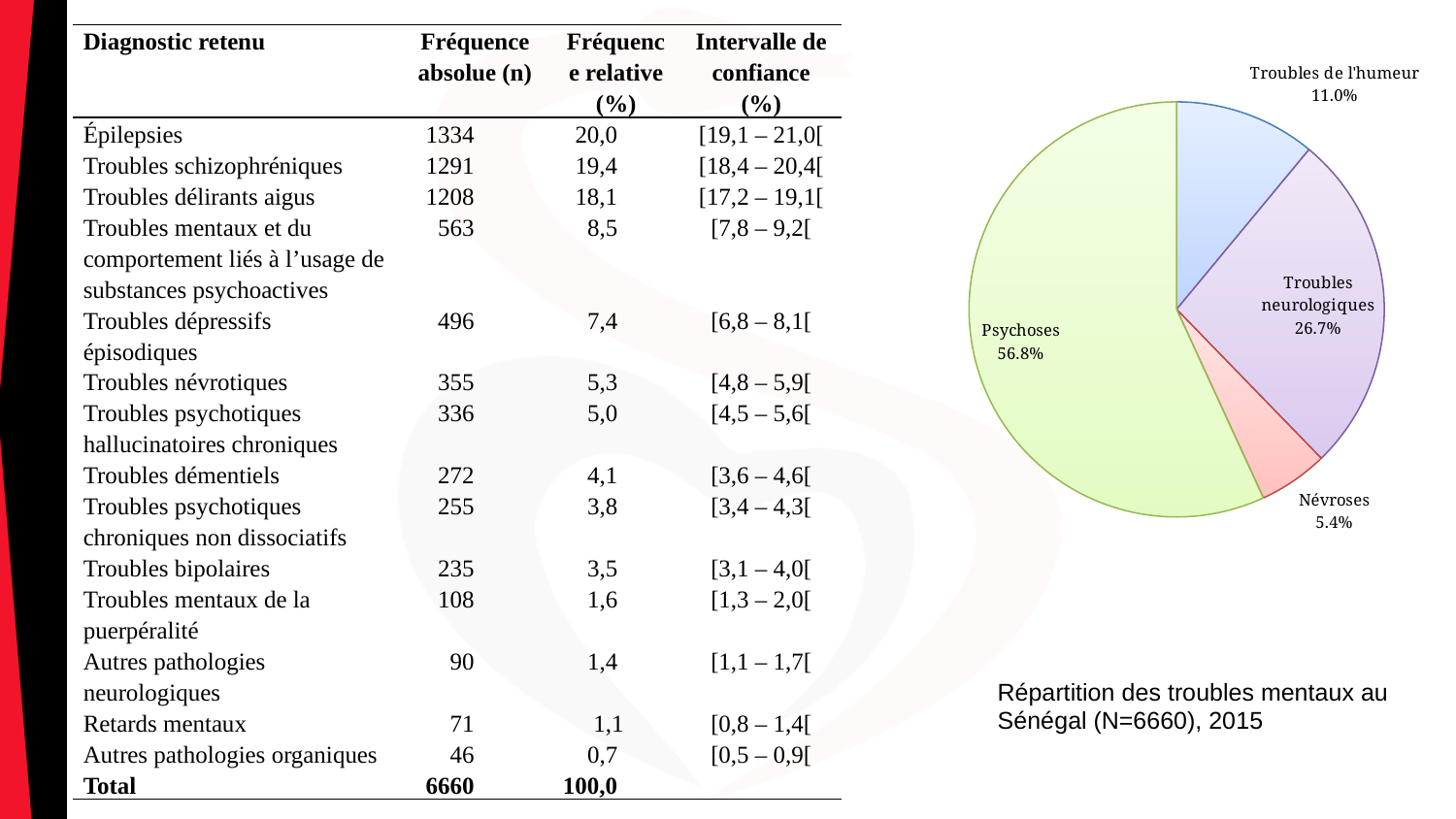
What share of the pie chart does Troubles de l'humeur represent? 11.0% Which category has the smallest slice in the pie chart? Névroses Which is larger in the pie chart, Troubles de l'humeur or Névroses? Troubles de l'humeur What is the difference in percentage points between Psychoses and Troubles neurologiques in the pie chart? 30.1 What share of the pie chart does Troubles neurologiques represent? 26.7% What is the difference in percentage points between Troubles de l'humeur and Névroses in the pie chart? 5.6 What share of the pie chart does Névroses represent? 5.4% How many slices does the pie chart have? 4 What kind of chart is shown on the slide? pie chart What is the caption of the pie chart? Répartition des troubles mentaux au Sénégal (N=6660), 2015 Which category has the largest slice in the pie chart? Psychoses